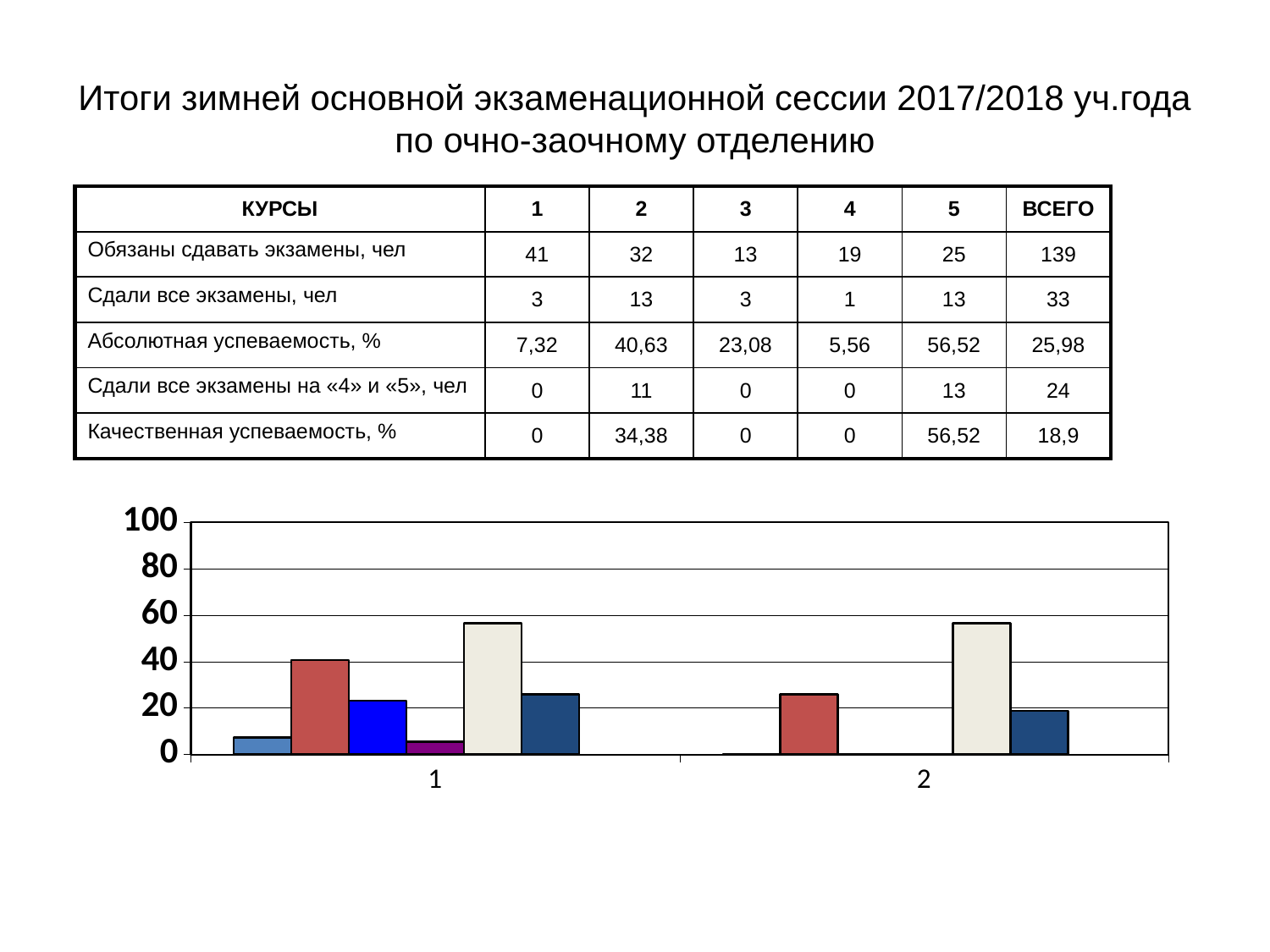
Is the value of the red bar in category 1 greater or less than 20? greater In category 1, which bar is taller: the red bar or the bright blue bar? the red bar Is the value of the cream-coloured bar in category 1 greater or less than 40? greater What is the highest value shown on the y axis of the chart? 100 Is the value of the purple bar in category 1 greater or less than 20? less In category 2, which bar is taller: the cream-coloured bar or the red bar? the cream-coloured bar What kind of chart is shown on the slide? bar chart How many categories are labelled on the x axis of the chart? 2 Which bar is the tallest in category 1? the cream-coloured bar